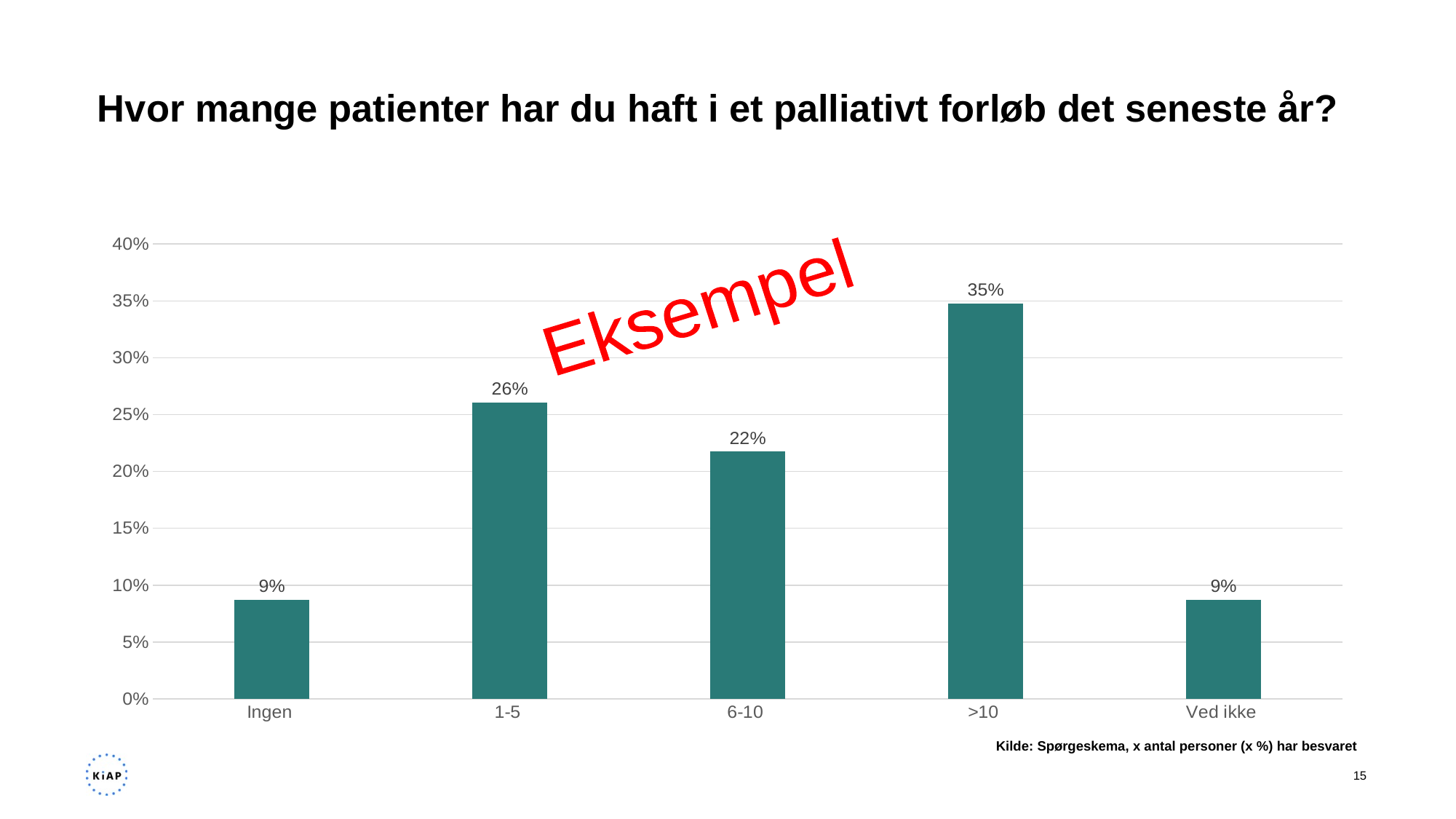
Which category has the highest value? >10 What is the title of the slide? Hvor mange patienter har du haft i et palliativt forløb det seneste år? Is the value for 'Ingen' greater or less than 10%? less What is the value for the 'Ved ikke' category? 9% What is the value for the '1-5' category? 26% What red word is written diagonally across the chart? Eksempel How many categories are shown on the x axis? 5 What is the value for the '>10' category? 35% What kind of chart is shown on the slide? Bar chart What is the difference between the values for '>10' and '6-10'? 13% Which is larger, the value for '1-5' or the value for '6-10'? 1-5 Is the value for '6-10' greater or less than 20%? greater